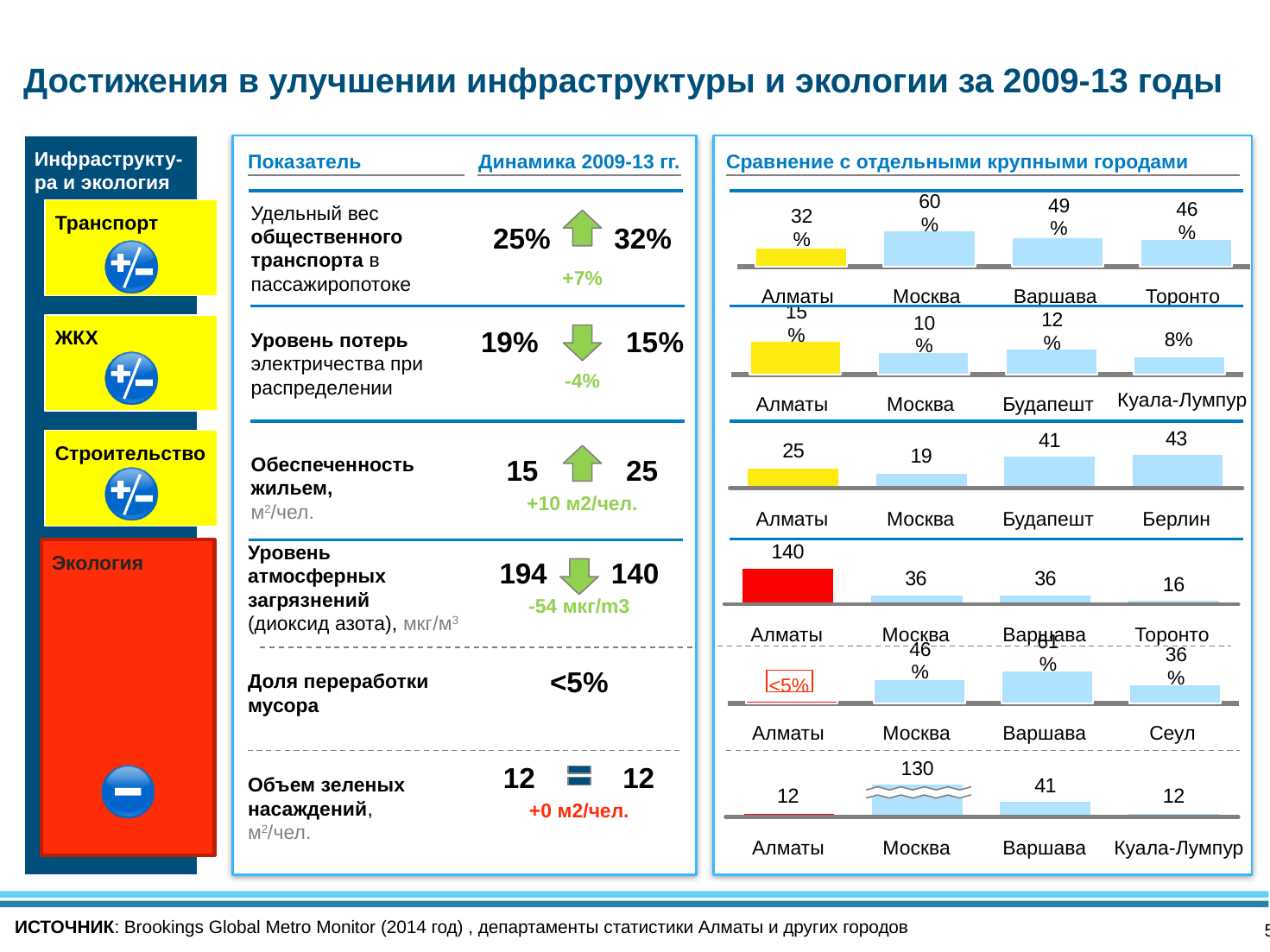
In the fourth chart of the comparison panel (atmospheric pollution), which city has the lowest value? Торонто In the third chart of the comparison panel (housing provision, m²/person), what is the difference between Берлин and Алматы? 18 In the fourth chart of the comparison panel (atmospheric pollution), what is the value for Алматы? 140 In the top chart of the 'Сравнение с отдельными крупными городами' panel (share of public transport), what is the value for Москва? 60% What type of chart is used in the 'Сравнение с отдельными крупными городами' panel? Bar chart In the second chart of the comparison panel (electricity losses), what is the value for Куала-Лумпур? 8% In the top chart of the comparison panel (share of public transport), which city has the lowest value? Алматы How many cities are shown in the bottom chart of the comparison panel (green space)? 4 In the fifth chart of the comparison panel (waste recycling share), what is the value for Сеул? 36% In the bottom chart of the comparison panel (green space, m²/person), what is the value for Москва? 130 In the third chart of the comparison panel (housing provision), which is larger, the value for Москва or the value for Будапешт? Будапешт In the second chart of the comparison panel (electricity losses), which city has the highest value? Алматы